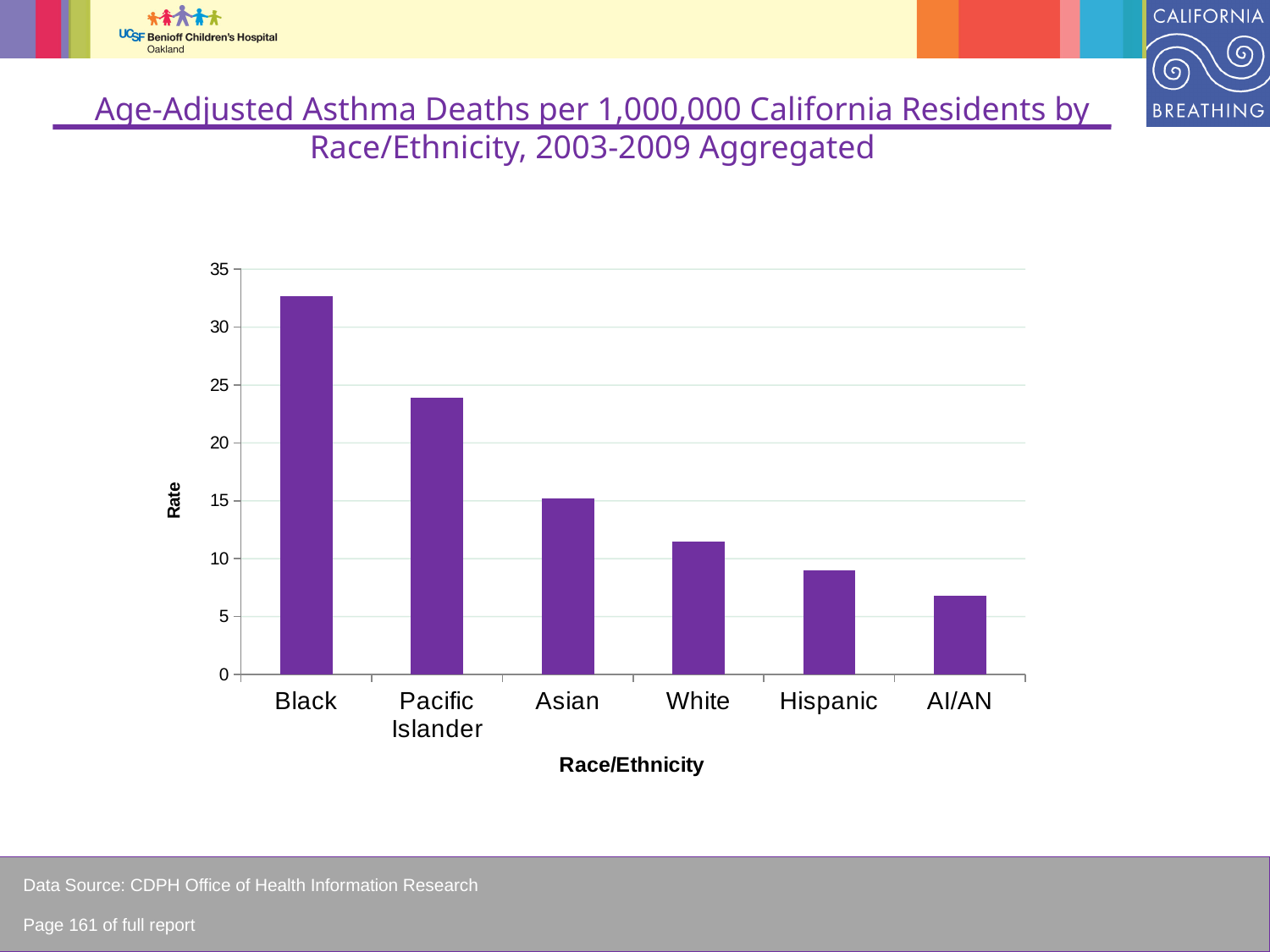
Which race/ethnicity has the highest age-adjusted asthma death rate? Black What is the label on the y axis of the chart? Rate Do the rates rise or fall moving from left to right across the categories? fall Which race/ethnicity has the lowest age-adjusted asthma death rate? AI/AN Is the rate for White greater or less than 10? greater Which has a higher rate, Pacific Islander or Asian? Pacific Islander Is the rate for Asian greater or less than 20? less What type of chart is shown on the slide? bar chart Is the rate for Hispanic greater or less than 10? less How many race/ethnicity categories are shown on the x axis? 6